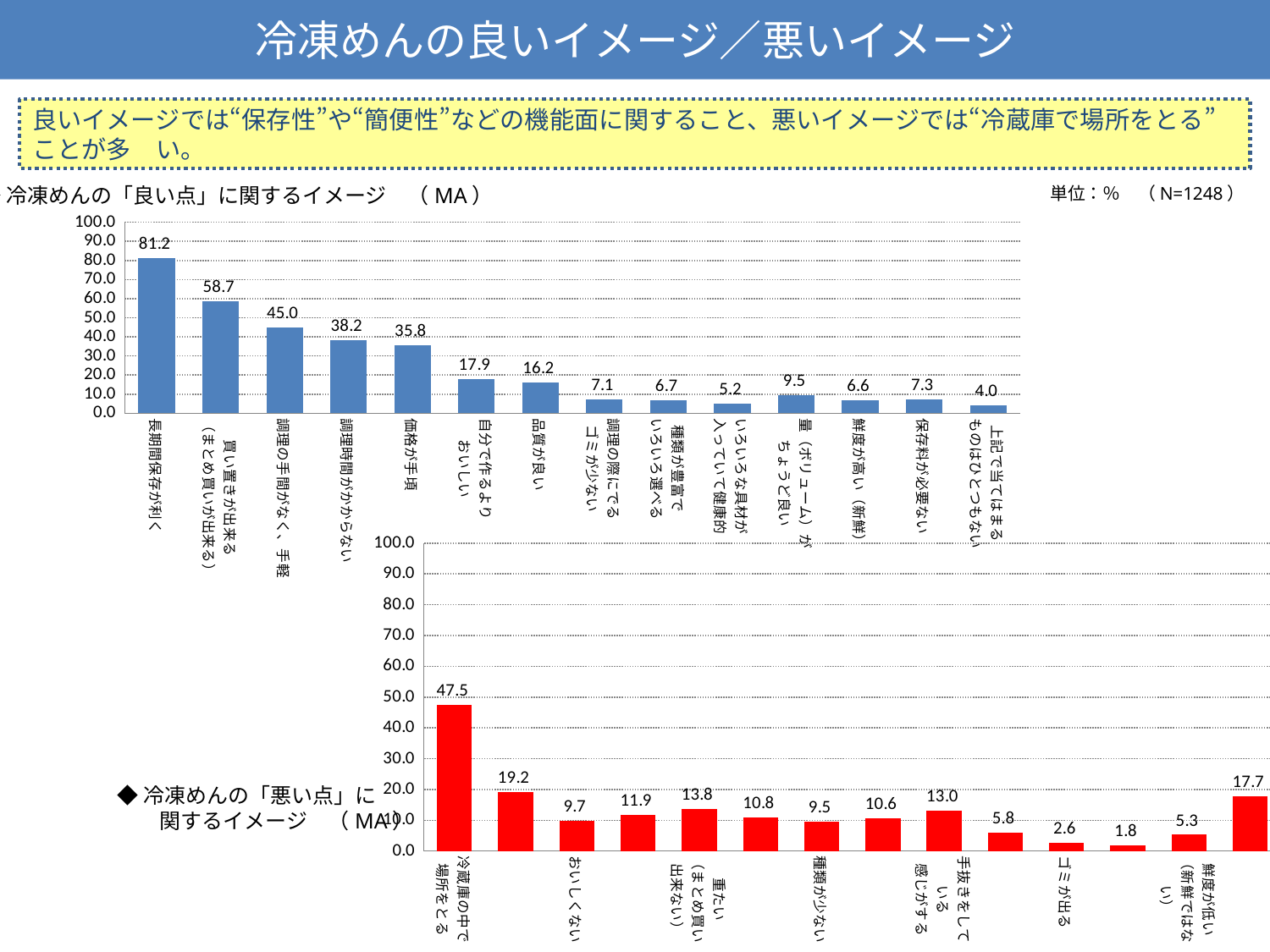
In the bottom chart (冷凍めんの「悪い点」に関するイメージ), what is the value for 冷蔵庫の中で場所をとる? 47.5 What sample size (N) is shown on the slide for the charts? N=1248 In the top chart (冷凍めんの「良い点」に関するイメージ), which category has the highest value? 長期間保存が利く How many categories are plotted in the top chart (冷凍めんの「良い点」に関するイメージ)? 14 In the bottom chart (冷凍めんの「悪い点」に関するイメージ), what is the lowest value shown? 1.8 In the top chart (冷凍めんの「良い点」に関するイメージ), what is the value for 価格が手頃? 35.8 In the top chart (冷凍めんの「良い点」に関するイメージ), what is the value for 長期間保存が利く? 81.2 In the bottom chart (冷凍めんの「悪い点」に関するイメージ), which category has the highest value? 冷蔵庫の中で場所をとる In the top chart (冷凍めんの「良い点」に関するイメージ), what is the lowest value shown? 4.0 In the top chart (冷凍めんの「良い点」に関するイメージ), what is the difference between 長期間保存が利く and 買い置きが出来る（まとめ買いが出来る）? 22.5 In the top chart (冷凍めんの「良い点」に関するイメージ), which is larger: 自分で作るよりおいしい or 品質が良い? 自分で作るよりおいしい What type of chart is the bottom chart (冷凍めんの「悪い点」に関するイメージ)? Bar chart